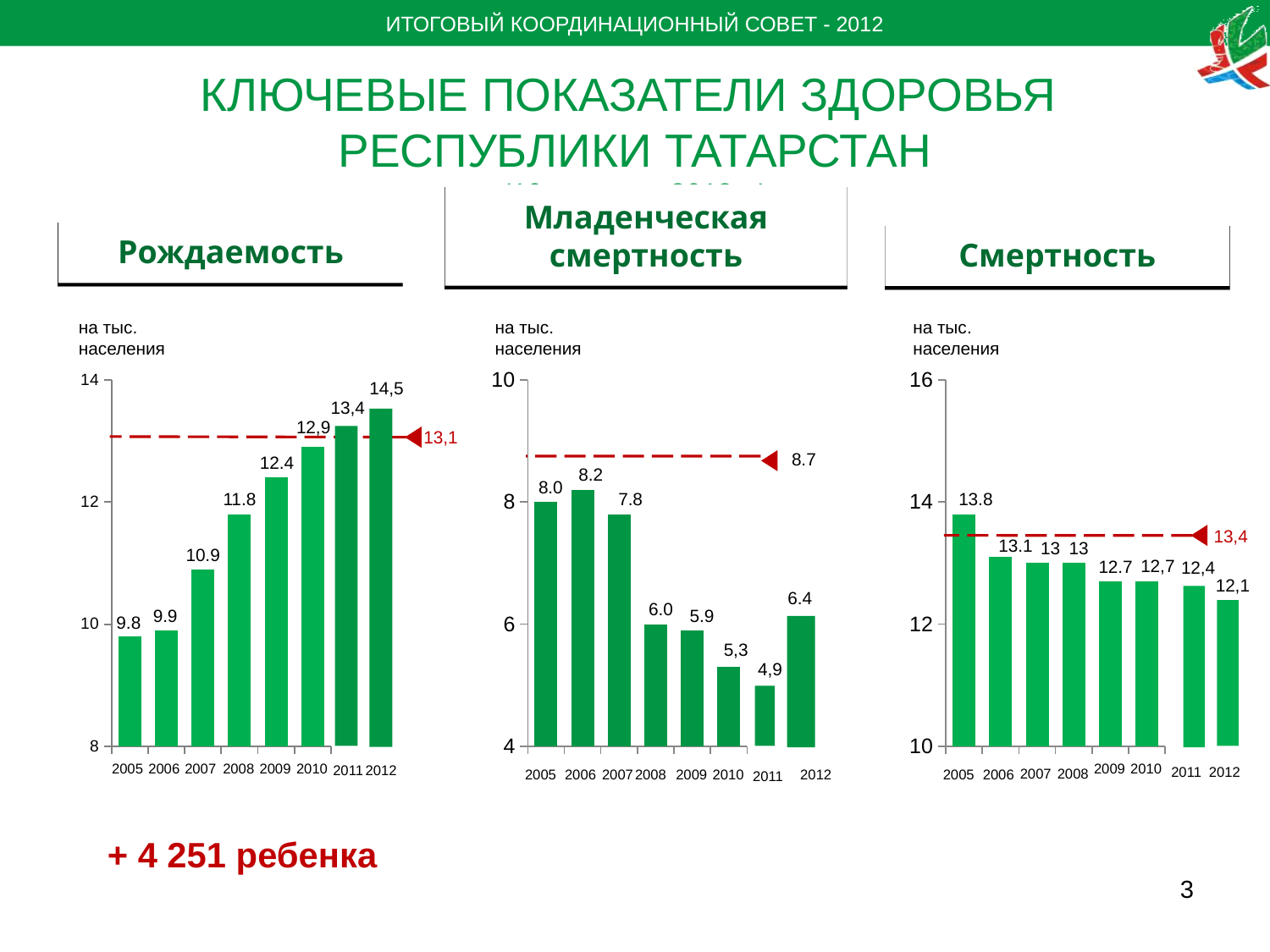
In the Младенческая смертность chart, how many years are plotted? 8 What kind of chart is the Смертность chart? bar chart In the Рождаемость chart, what is the difference between the 2008 and 2007 values? 0.9 In the Смертность chart, what is the difference between the 2005 and 2006 values? 0.7 In the Рождаемость chart, what is the value for 2012? 14,5 In the Младенческая смертность chart, which is larger, the value for 2008 or the value for 2012? 2012 In the Младенческая смертность chart, what is the value for 2011? 4,9 In the Рождаемость chart, which year has the lowest value? 2005 In the Младенческая смертность chart, which year has the highest value? 2006 In the Смертность chart, which year has the lowest value? 2012 In the Смертность chart, what is the value for 2005? 13.8 In the Рождаемость chart, do the values rise or fall from 2005 to 2012? rise